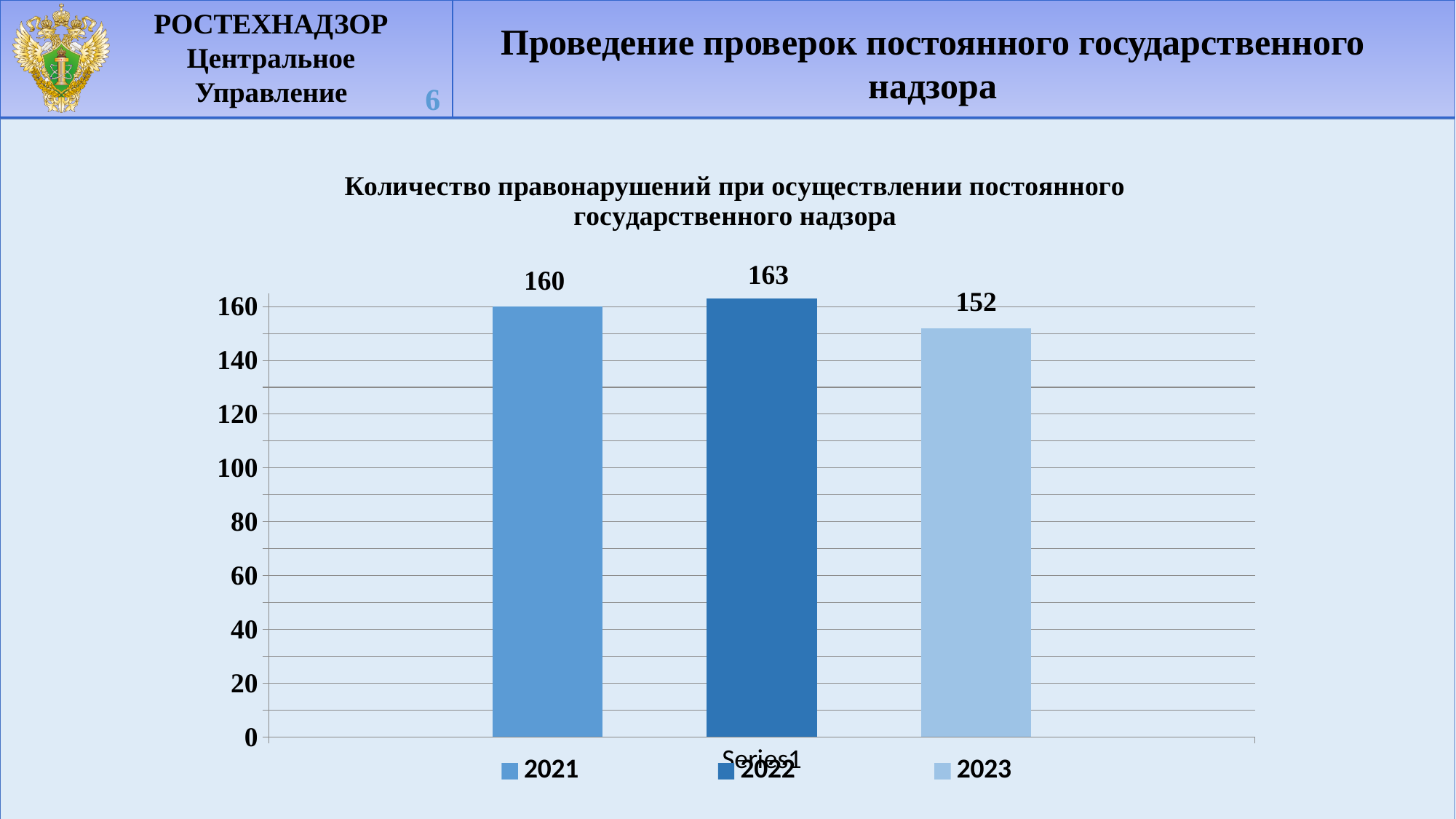
Which is larger, the value for 2021 or the value for 2023? 2021 Which year has the highest value? 2022 What is the title of the chart? Количество правонарушений при осуществлении постоянного государственного надзора What is the difference between the values for 2022 and 2023? 11 What is the value for 2022? 163 How many series does the legend list? 3 What is the value for 2021? 160 Is the value for 2023 greater or less than 140? greater Which year has the lowest value? 2023 What is the value for 2023? 152 What kind of chart is shown on the slide? bar chart What is the difference between the values for 2022 and 2021? 3